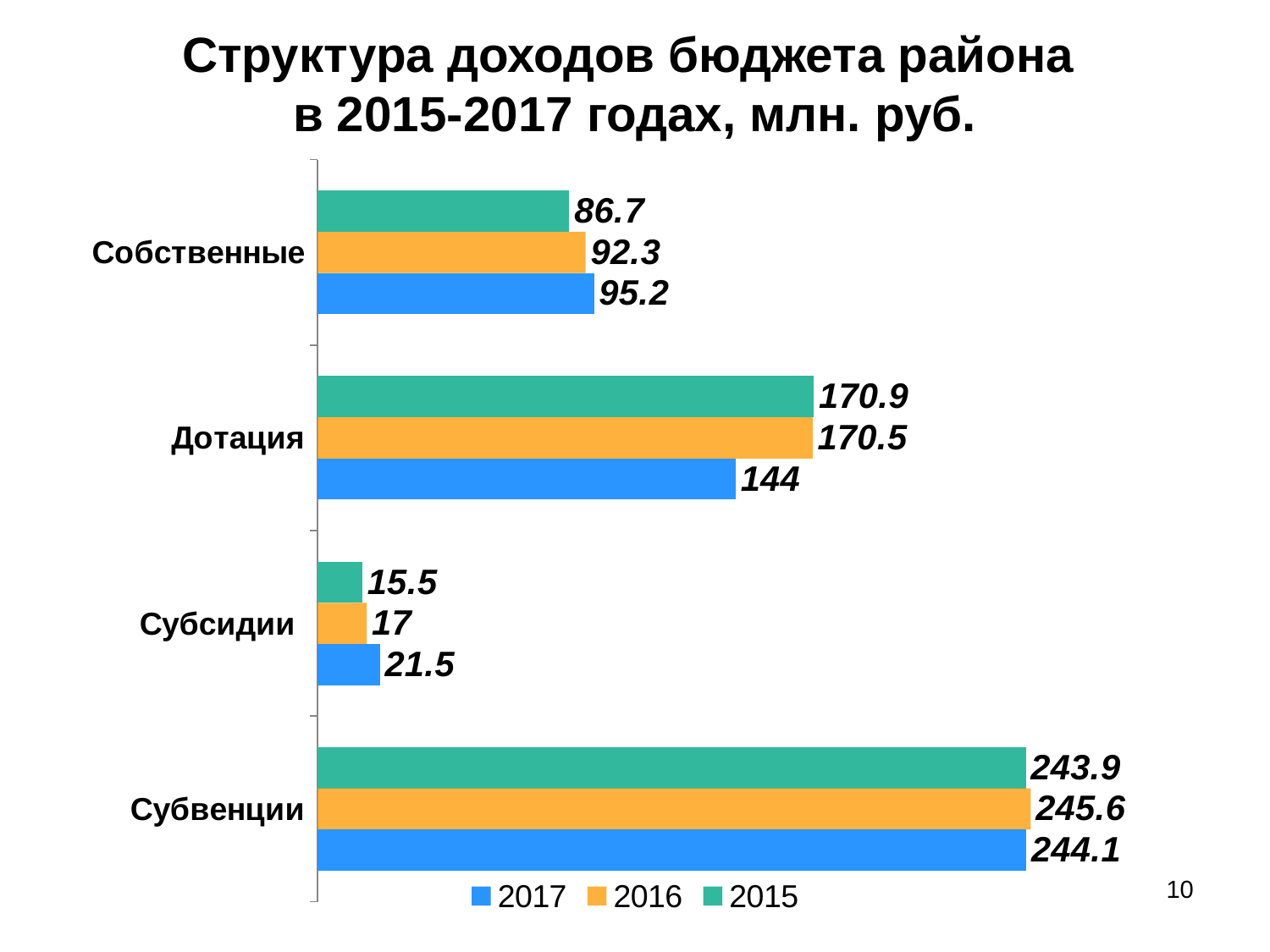
What kind of chart is shown on the slide? bar chart Which is larger for Субсидии: the 2017 value or the 2015 value? 2017 What is the value for Субвенции in 2016? 245.6 What is the value for Собственные in 2017? 95.2 What is the value for Субсидии in 2016? 17 Which category has the lowest value in 2015? Субсидии What is the difference between the 2015 and 2017 values for Дотация? 26.9 How many series does the legend list? 3 Which colour represents 2016 in the chart? orange What is the value for Дотация in 2015? 170.9 Which category has the highest value in 2017? Субвенции How many categories are shown on the chart? 4